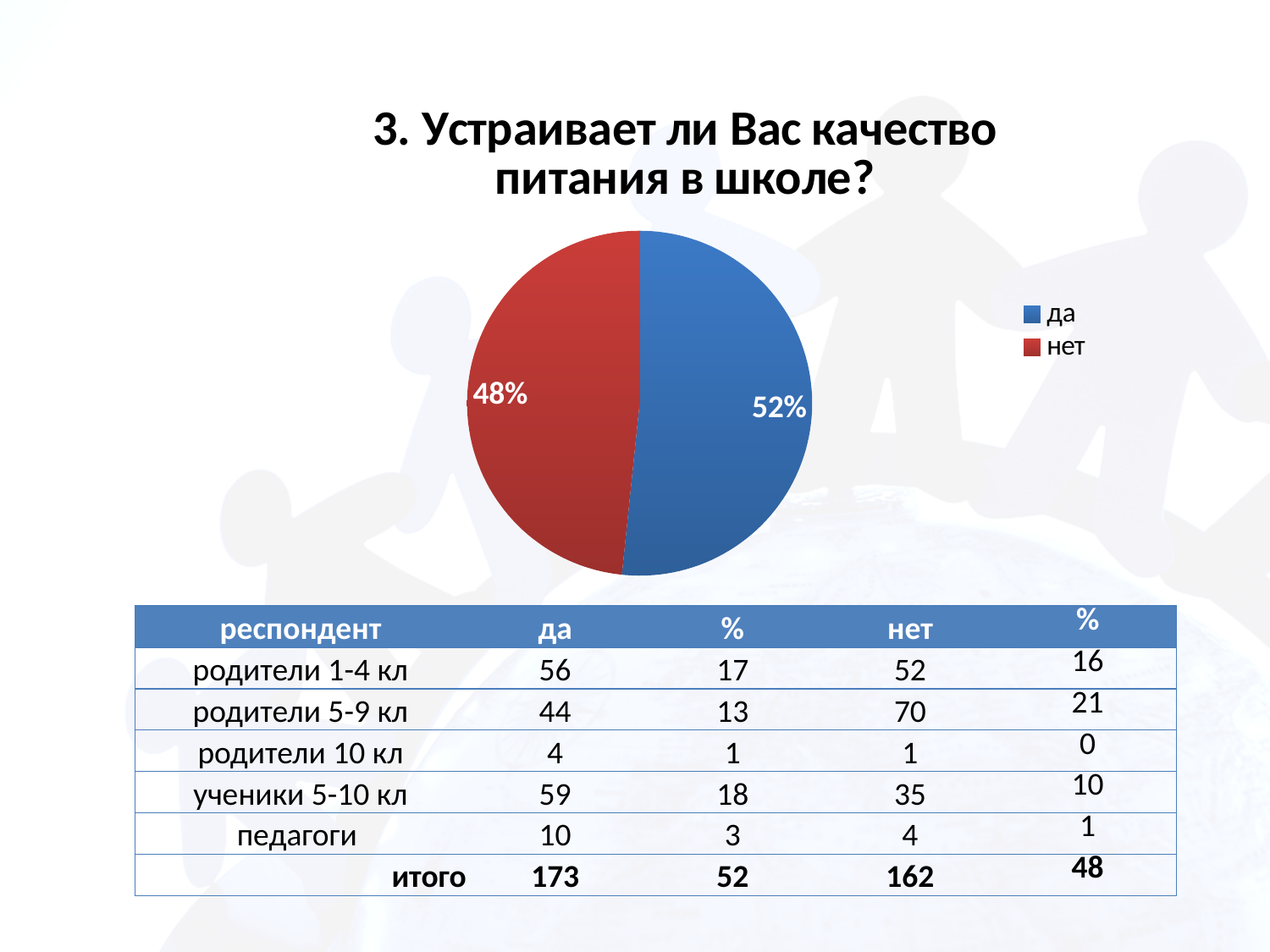
What is the difference in percentage points between the "да" and "нет" slices? 4 What colour is the "нет" slice in the pie chart? red Is the share of the "да" slice greater or less than 50%? greater What share of the pie does the "да" slice represent? 52% What share of the pie does the "нет" slice represent? 48% Which slice of the pie is the largest? да What kind of chart is shown on the slide? pie chart Which is larger, the "да" slice or the "нет" slice? да Which slice of the pie is the smallest? нет How many entries does the legend list? 2 What is the title of the chart? 3. Устраивает ли Вас качество питания в школе? How many slices does the pie chart have? 2